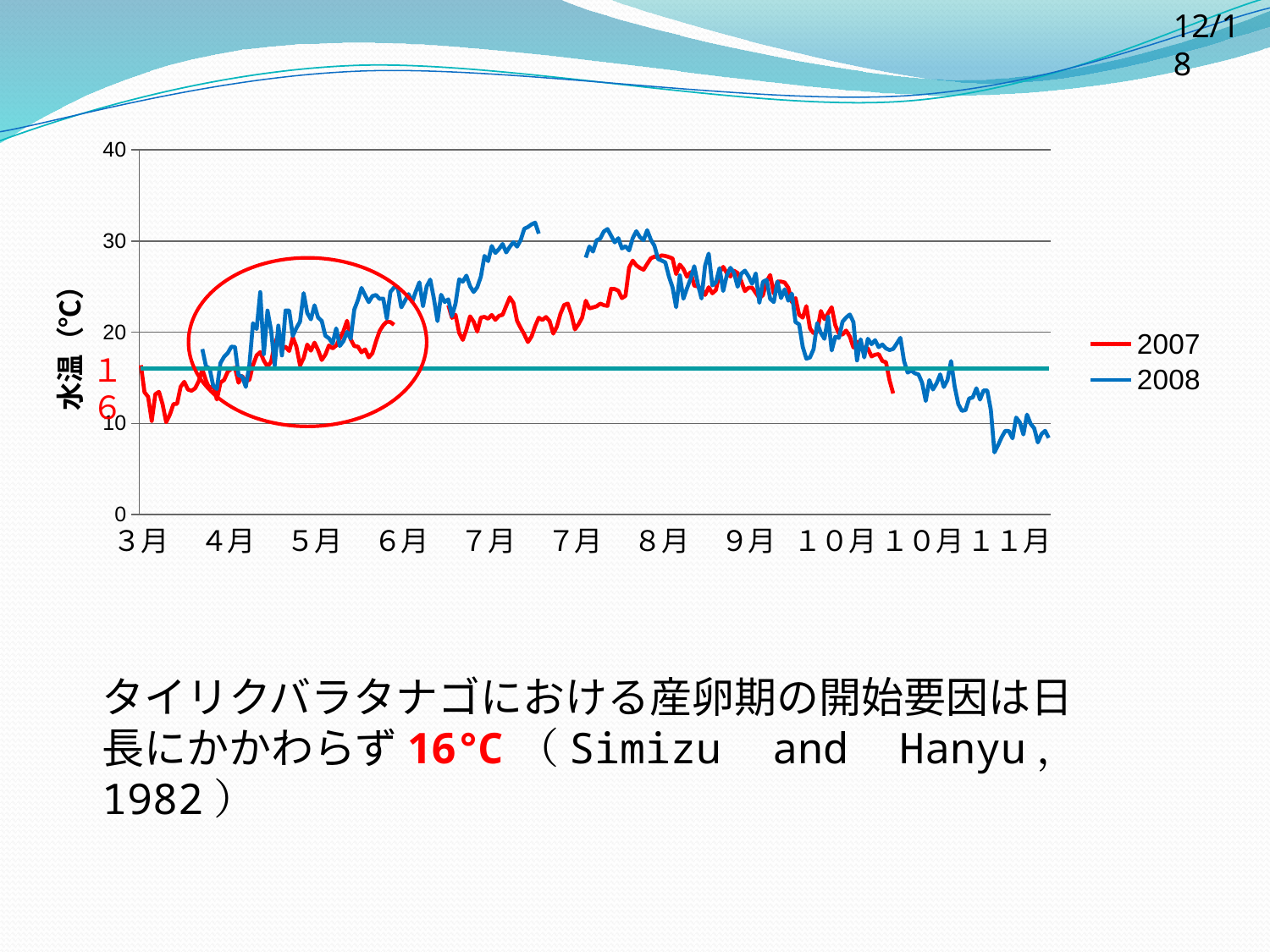
How many series does the legend list? 2 Is the peak value of the 2007 series greater or less than 30? less Which years are listed in the chart legend? 2007 and 2008 Is the value of the 2007 series at the start of 3月 greater or less than 20? less Do the water temperatures rise or fall along the x axis from 8月 to 11月? fall Is the peak value of the 2008 series greater or less than 30? greater What is the label of the y axis? 水温 (°C) Do the water temperatures rise or fall along the x axis from 3月 to 7月? rise What value does the horizontal reference line drawn across the chart mark? 16 What kind of chart is shown on the slide? line chart Which series reaches the higher peak water temperature, 2007 or 2008? 2008 What is the highest value shown on the y axis? 40